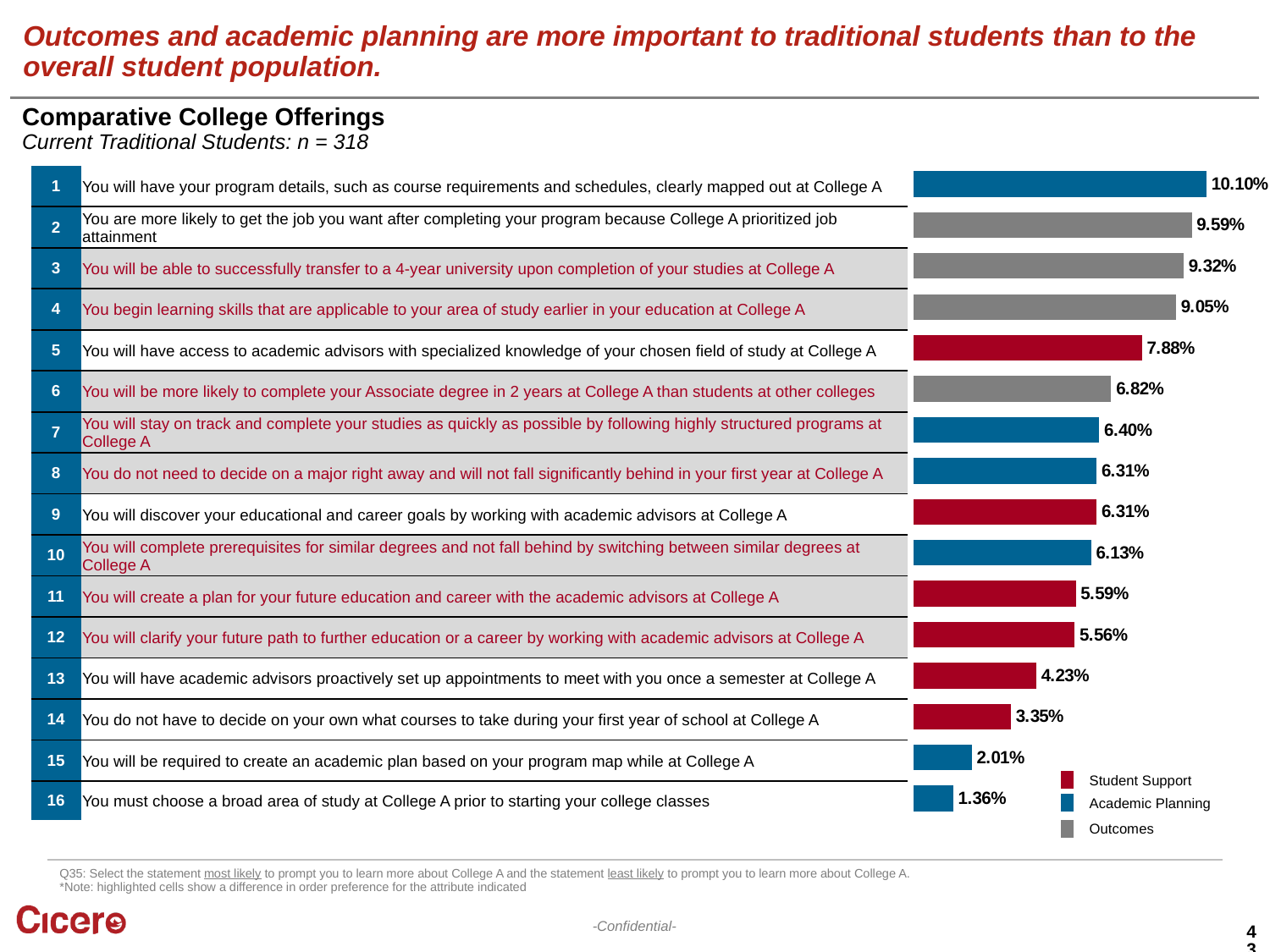
What is the value shown for statement 5, about access to academic advisors with specialized knowledge of your chosen field of study? 7.88% What is the value shown for statement 1, "You will have your program details, such as course requirements and schedules, clearly mapped out at College A"? 10.10% What is the difference between the values for statement 15 (2.01%) and statement 16 (1.36%)? 0.65% What kind of chart is shown on the slide? Bar chart Which statement has the highest value in the chart? Statement 1 (program details clearly mapped out at College A) How many statements are plotted in the chart? 16 What is the value shown for statement 13, about academic advisors proactively setting up appointments once a semester? 4.23% Which legend entry is shown in gray? Outcomes Which statement has the lowest value in the chart? Statement 16 (must choose a broad area of study prior to starting college classes) What is the difference between the values for statement 1 (10.10%) and statement 2 (9.59%)? 0.51% How many series does the legend list? 3 Which has a larger value: statement 6 (completing an Associate degree in 2 years) or statement 7 (staying on track by following highly structured programs)? Statement 6